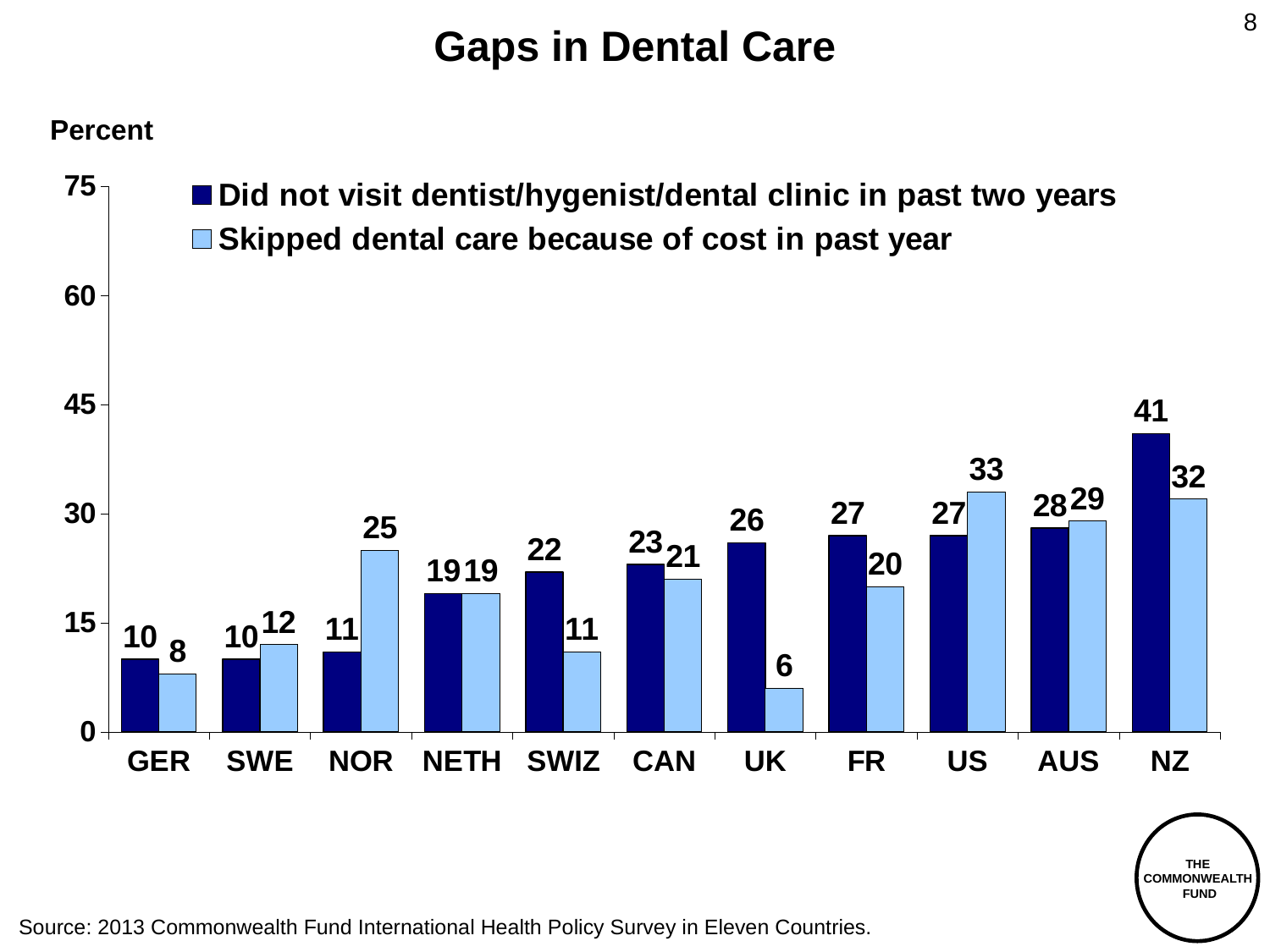
Which country has the lowest value for 'Skipped dental care because of cost in past year'? UK What kind of chart is shown on the slide? Bar chart What is the value for UK in the 'Skipped dental care because of cost in past year' series? 6 How many countries are shown on the x axis? 11 What is the title of the chart? Gaps in Dental Care Which is larger for NOR: 'Did not visit dentist/hygenist/dental clinic in past two years' or 'Skipped dental care because of cost in past year'? Skipped dental care because of cost in past year What is the value for NOR in the 'Skipped dental care because of cost in past year' series? 25 How many series does the legend list? 2 What is the value for NZ in the 'Did not visit dentist/hygenist/dental clinic in past two years' series? 41 What is the difference between the two series for UK? 20 What is the difference between the 'Skipped dental care because of cost in past year' values for US and GER? 25 Which country has the highest value for 'Did not visit dentist/hygenist/dental clinic in past two years'? NZ